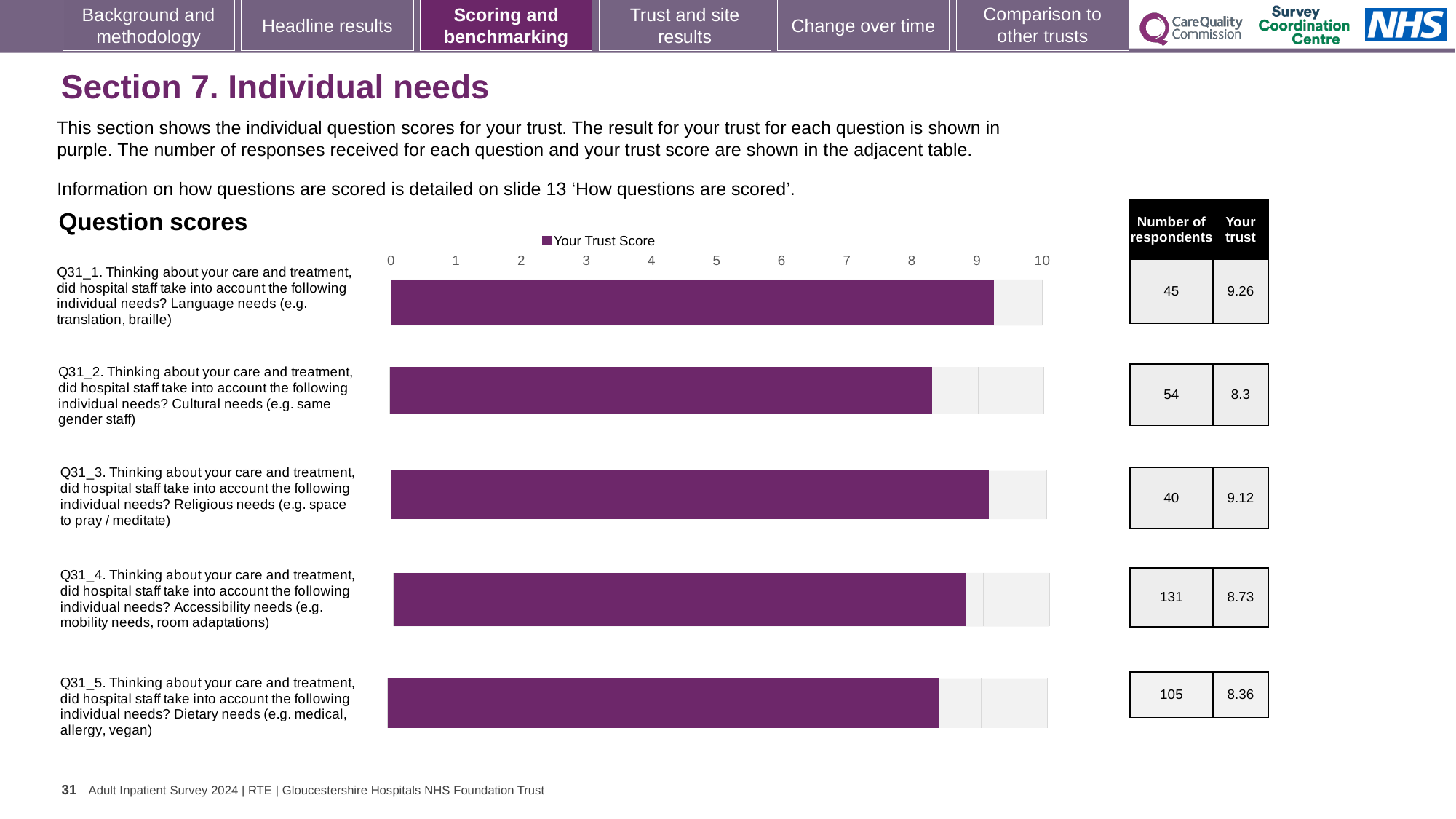
Is the trust score for Q31_2 (Cultural needs) greater or less than 9? less Which question has the lowest trust score? Q31_2 (Cultural needs) What is the difference between the trust scores for Q31_1 and Q31_2? 0.96 Which has a higher trust score, Q31_3 (Religious needs) or Q31_4 (Accessibility needs)? Q31_3 (Religious needs) How many questions are plotted in the chart? 5 Which question has the highest trust score? Q31_1 (Language needs) What is the trust score for Q31_5 (Dietary needs)? 8.36 What kind of chart is shown on the slide? Bar chart What is the trust score for Q31_4 (Accessibility needs)? 8.73 How many series does the chart legend list? 1 What is the trust score for Q31_1 (Language needs)? 9.26 What is the name of the series shown in the chart legend? Your Trust Score